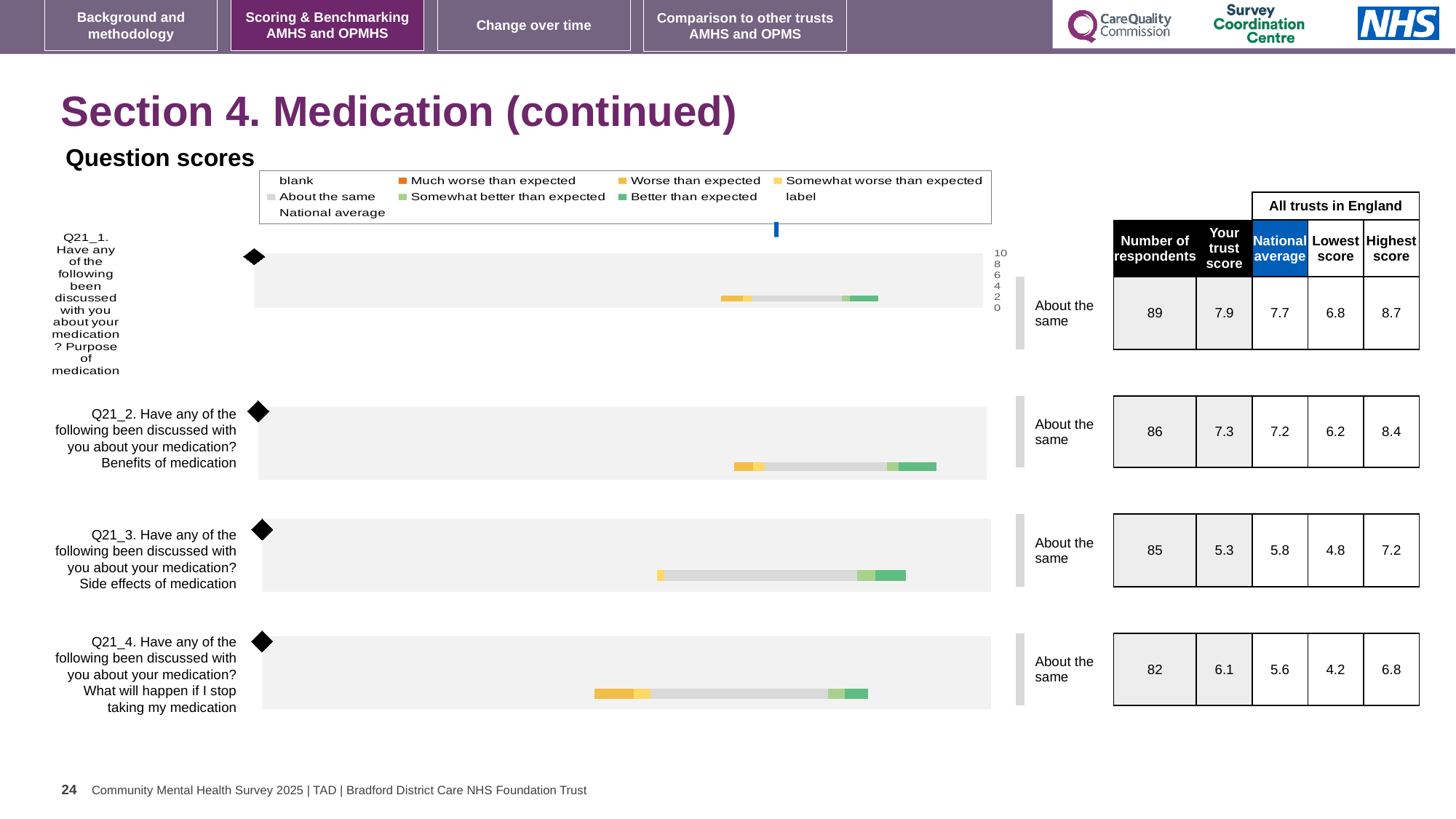
Which question has the highest 'Your trust score'? Q21_1 (Purpose of medication) How many questions (Q21_1 to Q21_4) are plotted on the slide? 4 How many respondents are shown for Q21_4 (What will happen if I stop taking my medication)? 82 What is the national average for Q21_3 (Side effects of medication)? 5.8 What is the lowest score across all trusts in England for Q21_2 (Benefits of medication)? 6.2 What kind of chart is used to show the question scores on this slide? Bar chart What benchmark category is shown for Q21_3 (Side effects of medication)? About the same For Q21_2 (Benefits of medication), what is the difference between the highest score and the lowest score across all trusts in England? 2.2 What is the 'Your trust score' value for Q21_1 (Purpose of medication)? 7.9 For Q21_1, how much higher is the trust score than the national average? 0.2 Which question has the lowest 'Your trust score'? Q21_3 (Side effects of medication) For Q21_4, which is larger: the trust score or the national average? The trust score (6.1)